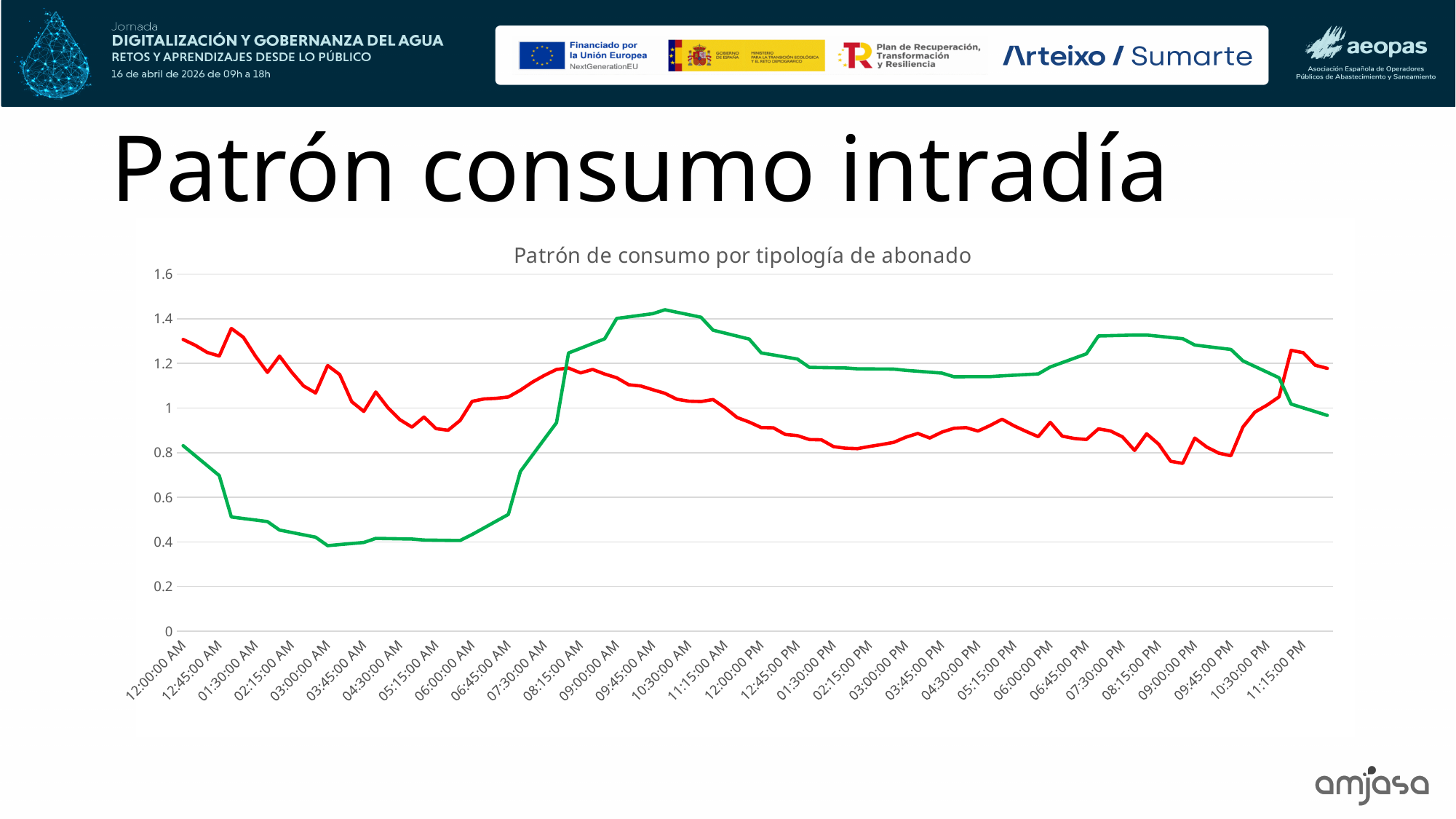
Is the value of the green line at 09:45:00 AM greater or less than 1.2? greater Does the green line rise or fall between 06:00:00 AM and 09:45:00 AM? rise At 09:45:00 AM, which line has the higher value, the red or the green? green What colours are the two lines on the chart? red and green How many time labels are shown on the x axis? 32 What is the title of the chart? Patrón de consumo por tipología de abonado Is the value of the red line at 12:00:00 AM greater or less than 1.2? greater Is the value of the green line at 03:00:00 AM greater or less than 0.6? less How many lines (series) are plotted on the chart? 2 At 12:00:00 AM, which line has the higher value, the red or the green? red What kind of chart is shown on the slide? line chart